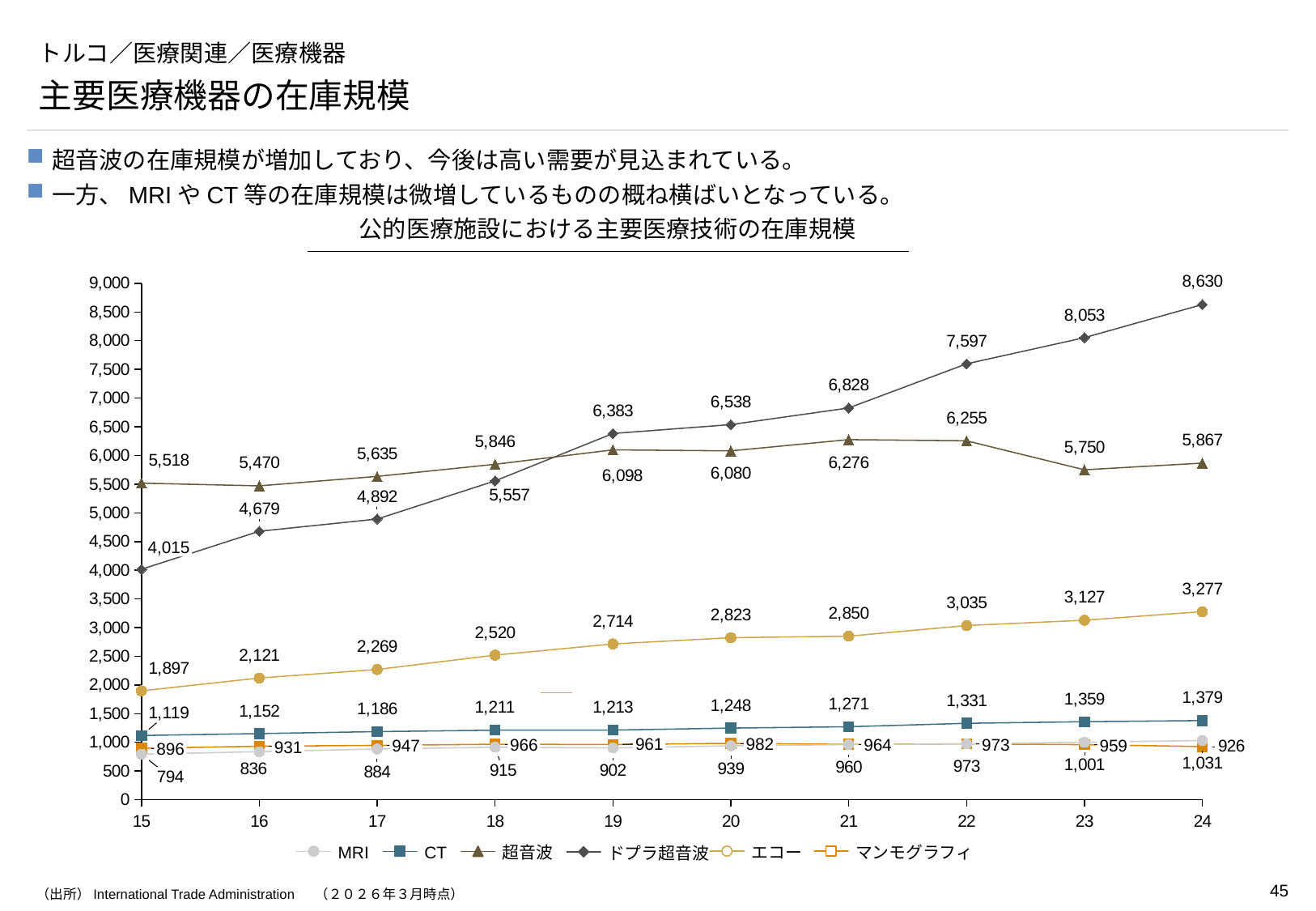
24年において、超音波とドプラ超音波ではどちらの値が大きいですか。 ドプラ超音波 凡例にはいくつの系列が示されていますか。 6 ドプラ超音波の24年と15年の値の差はいくつですか。 4,615 エコーの24年の値は3,000より大きいですか、小さいですか。 大きい このグラフの種類は何ですか。 折れ線グラフ エコーの20年の値はいくつですか。 2,823 横軸には何年分のデータ点がありますか。 10 MRIの値が最も低いのは何年ですか。 15 超音波の15年の値はいくつですか。 5,518 ドプラ超音波の値が最も高いのは何年ですか。 24 CTの24年の値はいくつですか。 1,379 ドプラ超音波の24年の値はいくつですか。 8,630